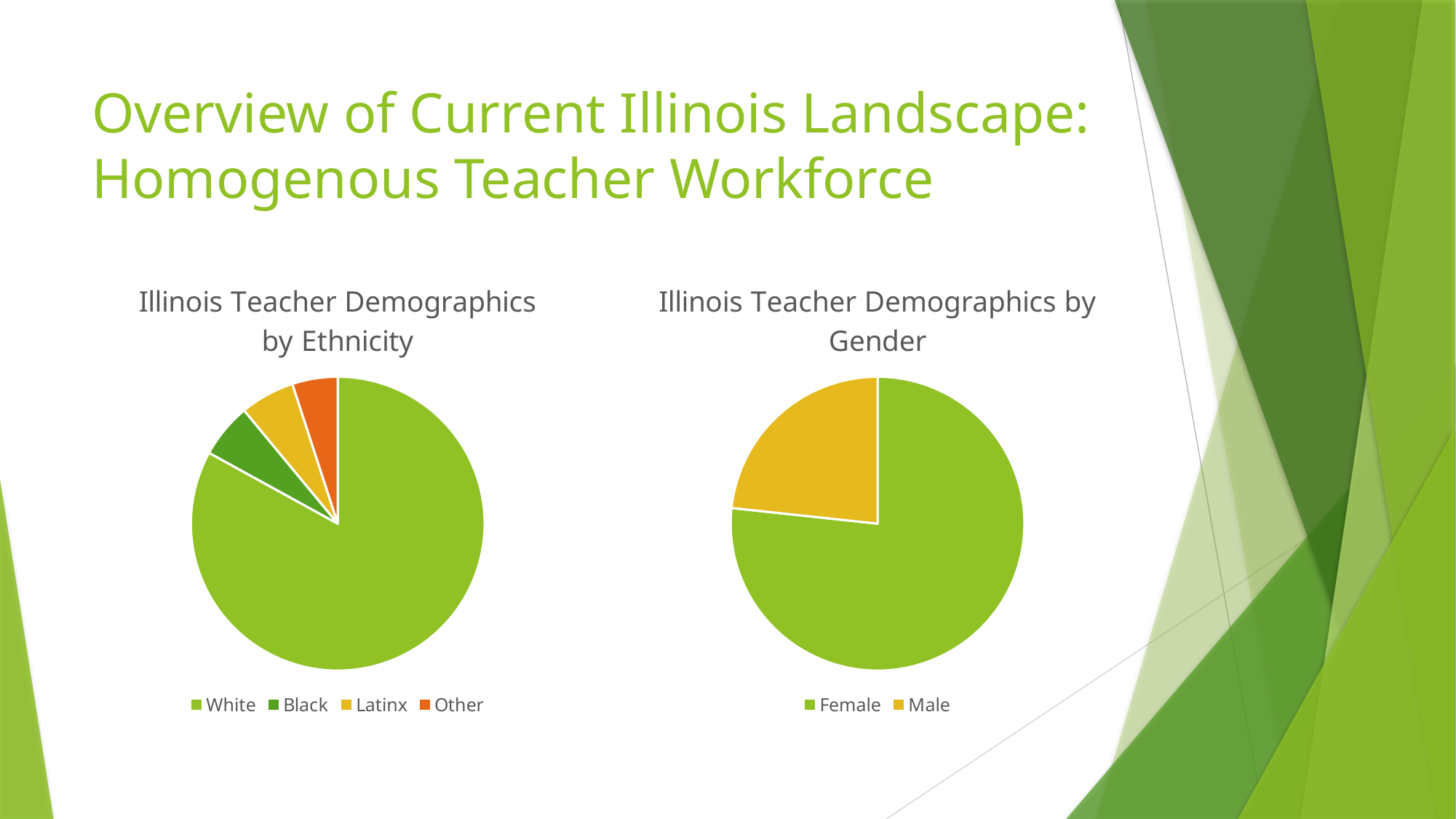
In the 'Illinois Teacher Demographics by Gender' chart, which category has the largest slice? Female What are the legend entries of the 'Illinois Teacher Demographics by Ethnicity' chart? White, Black, Latinx, Other In the 'Illinois Teacher Demographics by Gender' chart, how many categories does the legend list? 2 In the 'Illinois Teacher Demographics by Ethnicity' chart, how many categories does the legend list? 4 In the 'Illinois Teacher Demographics by Ethnicity' chart, which slice is larger, Black or White? White In the 'Illinois Teacher Demographics by Ethnicity' chart, which category has the largest slice? White In the 'Illinois Teacher Demographics by Gender' chart, which category has the smallest slice? Male In the 'Illinois Teacher Demographics by Gender' chart, which slice is larger, Male or Female? Female What kind of chart is the 'Illinois Teacher Demographics by Gender' chart? pie chart What is the title of the pie chart on the right side of the slide? Illinois Teacher Demographics by Gender In the 'Illinois Teacher Demographics by Ethnicity' chart, which slice is larger, White or Black? White What kind of chart is the 'Illinois Teacher Demographics by Ethnicity' chart? pie chart